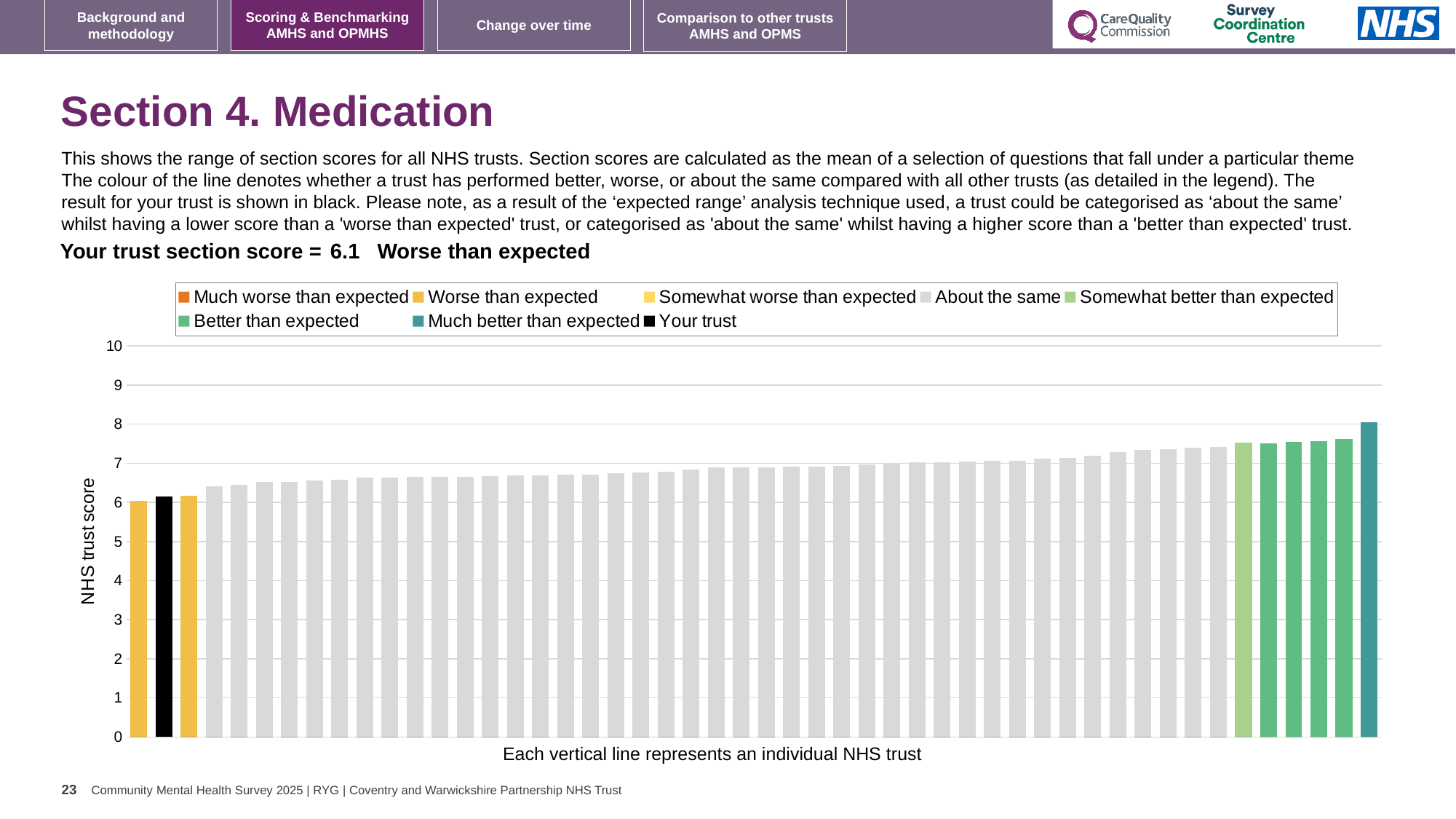
How many entries does the chart legend list? 8 Is the shortest bar in the chart greater or less than 7? less What is the label on the horizontal axis of the chart? Each vertical line represents an individual NHS trust Do the bar values rise or fall from left to right along the x axis? rise What is the label on the vertical axis of the chart? NHS trust score How many black bars (Your trust) are shown in the chart? 1 What is the section score for your trust shown on the slide? 6.1 Is the tallest bar in the chart greater or less than 7? greater What kind of chart is shown on the slide? bar chart Is the value for your trust (the black bar) greater or less than 5? greater Which legend category does the shortest bar belong to? Worse than expected Which legend category does the tallest bar belong to? Much better than expected